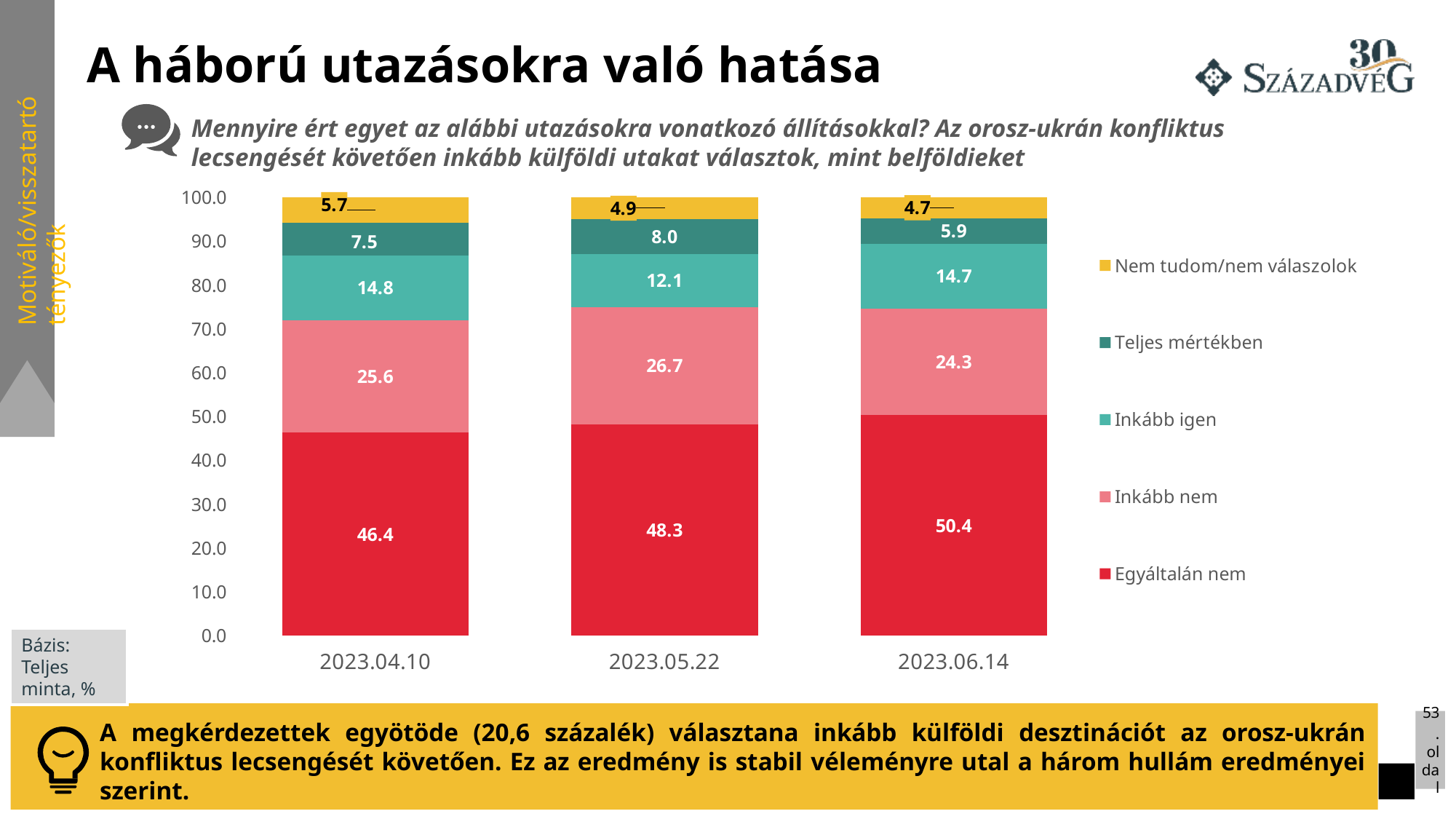
What is the value for "Egyáltalán nem" on 2023.06.14? 50.4 What is the value for "Teljes mértékben" on 2023.04.10? 7.5 What is the difference between the "Egyáltalán nem" values on 2023.06.14 and 2023.04.10? 4.0 How many series does the legend list? 5 What kind of chart is shown on the slide? Stacked bar chart On which date is the "Teljes mértékben" value lowest? 2023.06.14 Which is larger: "Inkább nem" on 2023.05.22 or "Inkább nem" on 2023.06.14? 2023.05.22 Does the "Egyáltalán nem" value rise or fall across the three dates from left to right? Rise How many dates (categories) are shown on the x axis? 3 On which date is the "Egyáltalán nem" value highest? 2023.06.14 What is the value for "Inkább igen" on 2023.05.22? 12.1 What is the value for "Nem tudom/nem válaszolok" on 2023.06.14? 4.7